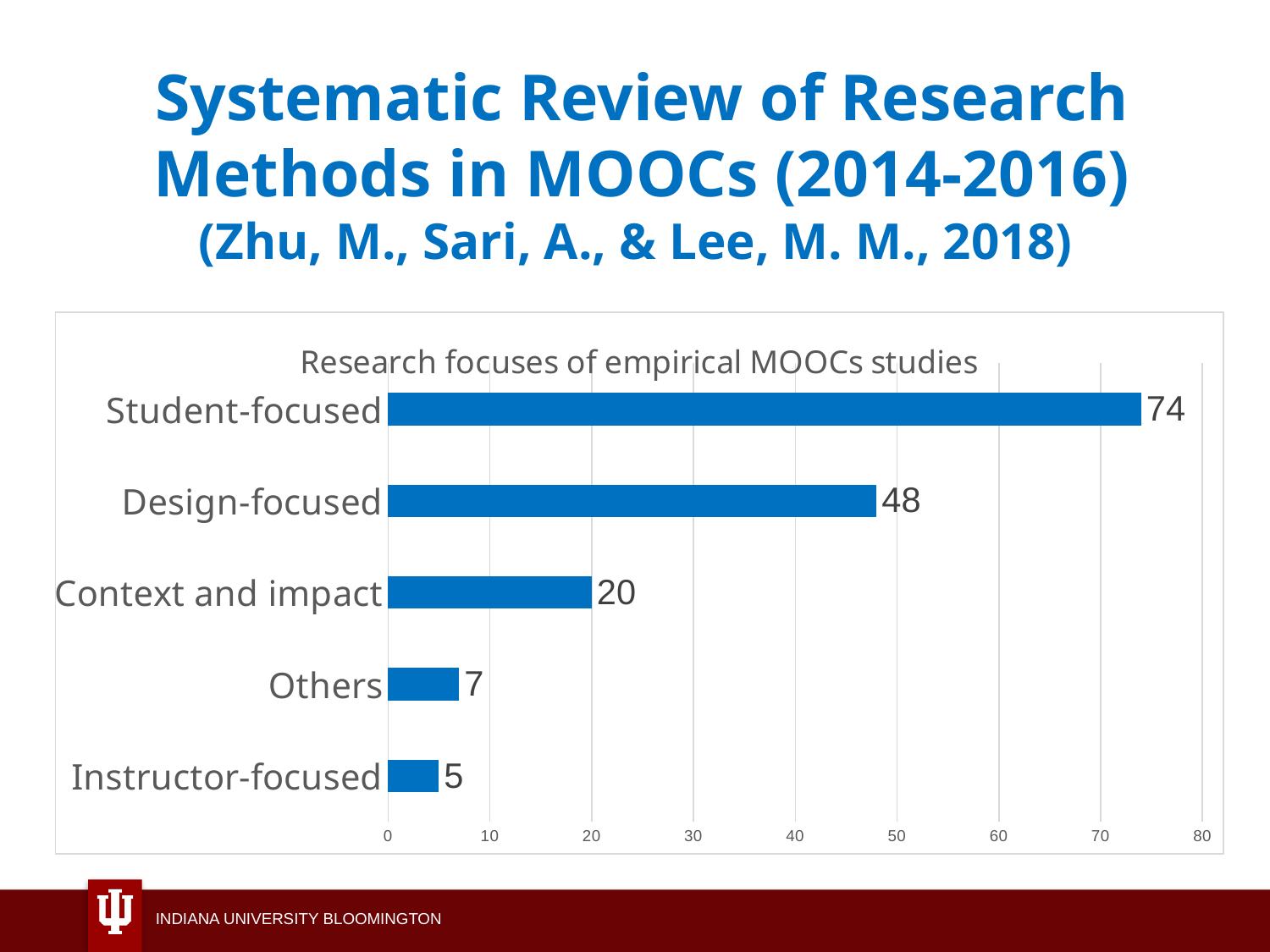
What is the title of the chart? Research focuses of empirical MOOCs studies What kind of chart is shown? Bar chart Which is larger, Context and impact or Others? Context and impact What is the value for Student-focused? 74 What is the value for Instructor-focused? 5 What is the difference between the Others and Instructor-focused values? 2 What is the value for Design-focused? 48 Which category has the highest value? Student-focused What is the value for Context and impact? 20 What is the difference between the Student-focused and Design-focused values? 26 Which category has the lowest value? Instructor-focused How many categories are shown in the chart? 5